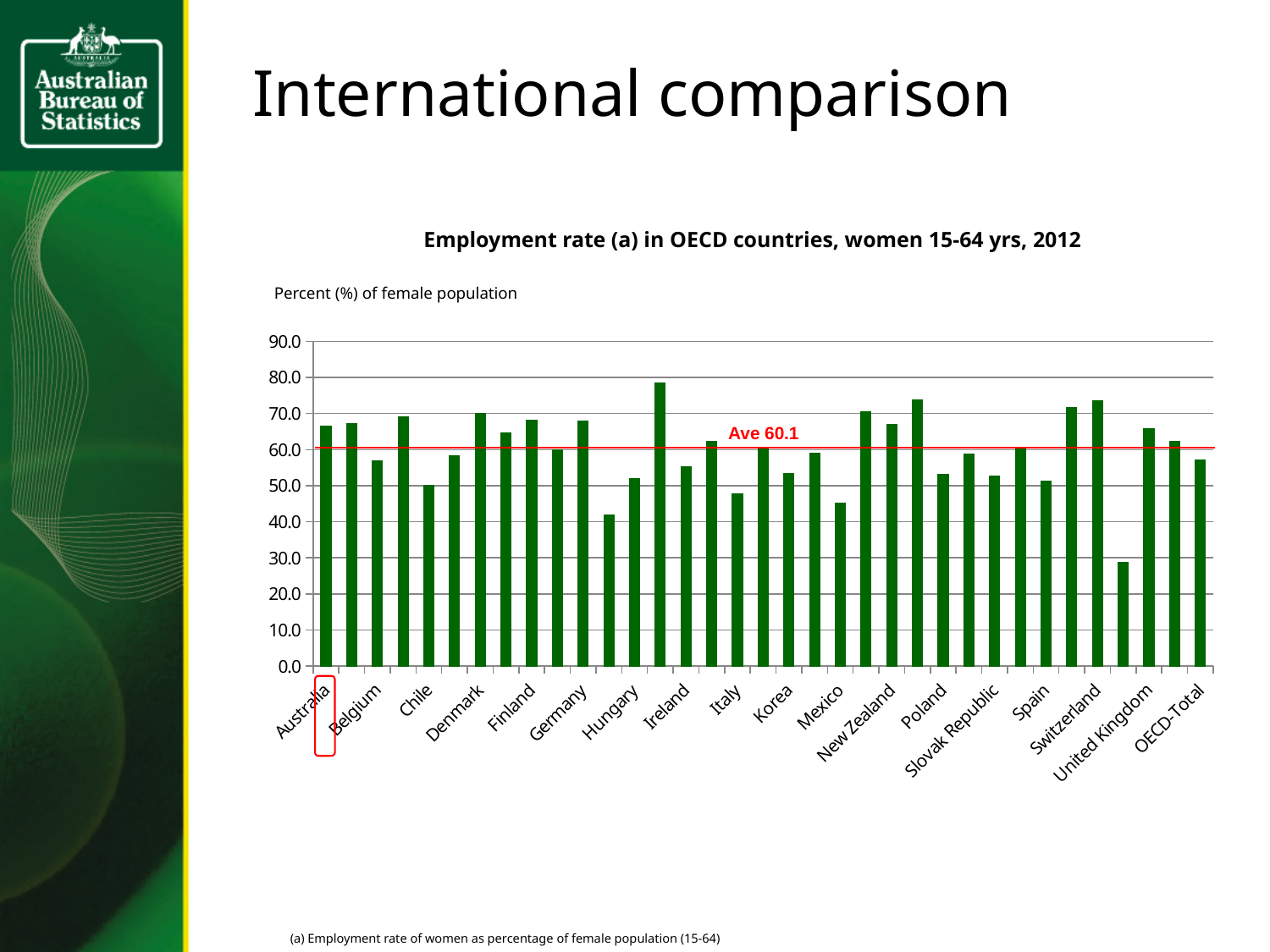
What average value is marked by the red line on the chart? 60.1 Is the value for United Kingdom greater or less than 60? greater Is the value for Italy greater or less than 50? less What unit is shown on the vertical axis of the chart? Percent (%) of female population Is the value for OECD-Total greater or less than 60? less What kind of chart is shown on the slide? bar chart What is the title of the chart? Employment rate (a) in OECD countries, women 15-64 yrs, 2012 Which has the higher employment rate, Australia or Mexico? Australia Which has the higher employment rate, Switzerland or Italy? Switzerland